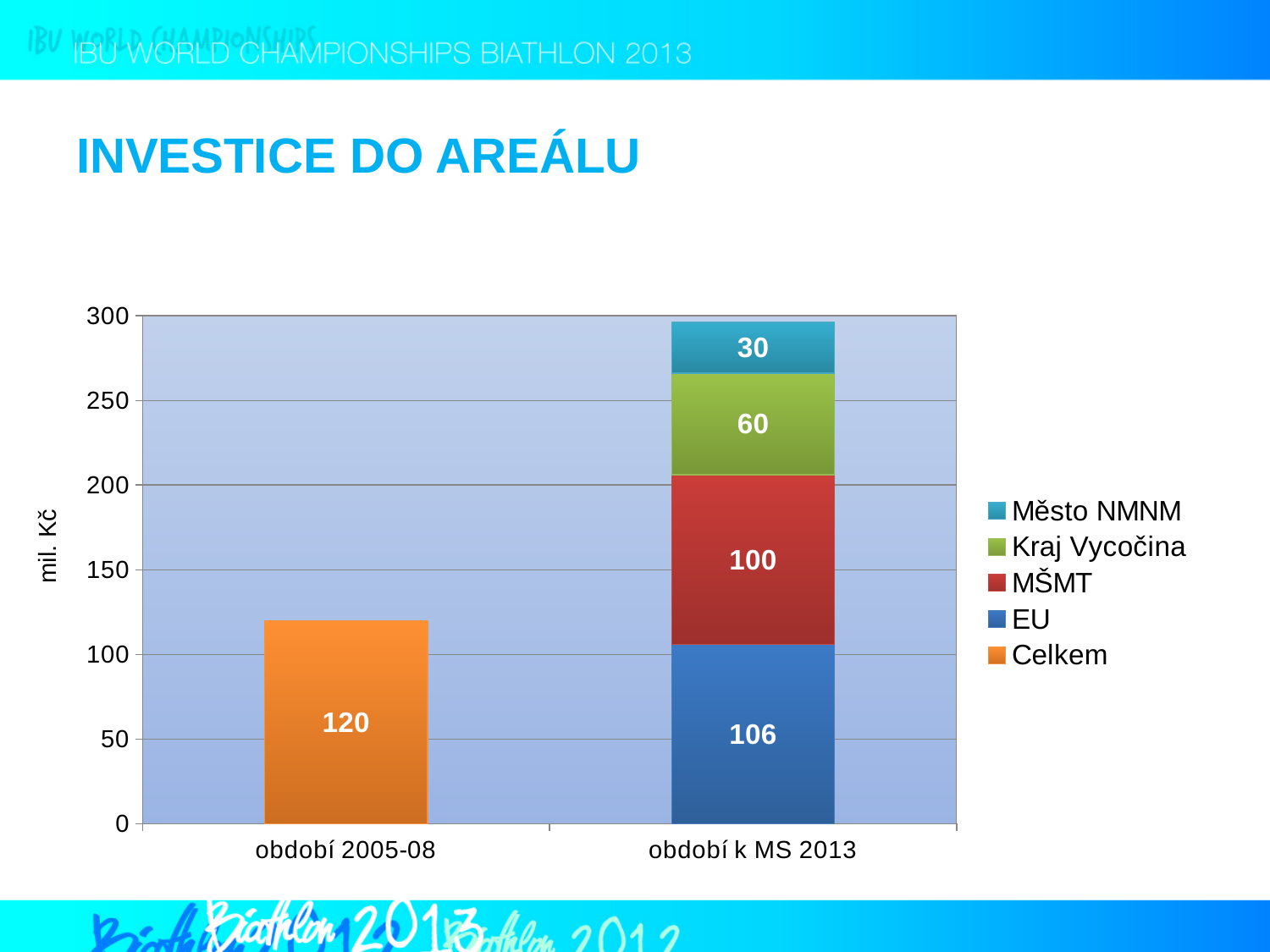
What kind of chart is shown on the slide? Stacked bar chart Which series has the smallest value in období k MS 2013? Město NMNM What is the difference between the EU value and the MŠMT value in období k MS 2013? 6 What is the value for Kraj Vycočina in období k MS 2013? 60 Which is larger in období k MS 2013: Kraj Vycočina or Město NMNM? Kraj Vycočina What is the total of the stacked bar for období k MS 2013? 296 What is the value for MŠMT in období k MS 2013? 100 What unit is shown on the vertical axis label? mil. Kč What is the value for Město NMNM in období k MS 2013? 30 What is the value for Celkem in období 2005-08? 120 How many series does the legend list? 5 What is the value for EU in období k MS 2013? 106